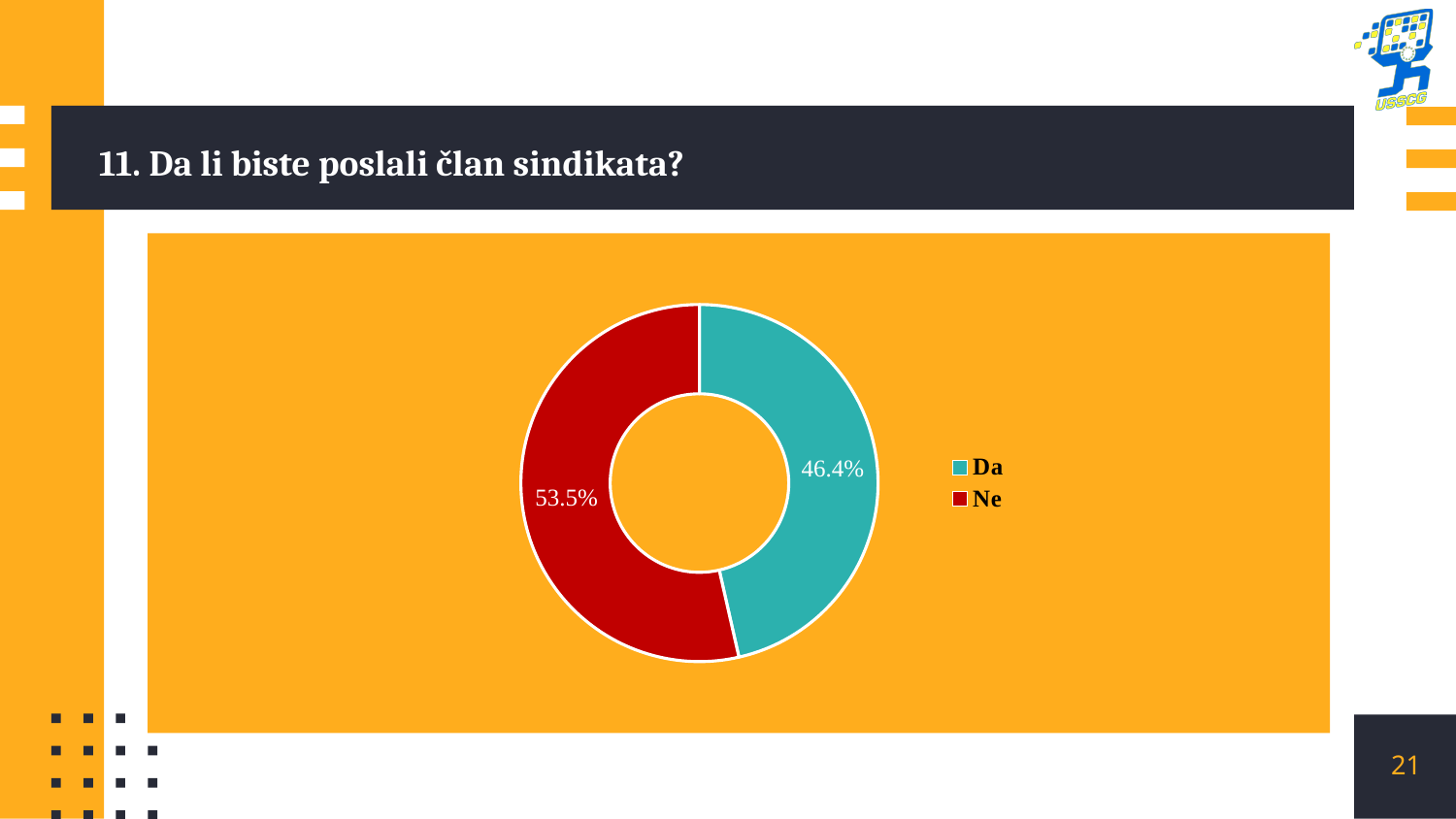
What colour represents "Ne" in the chart? Red Is the share for "Da" greater or less than 50%? less Which category has the largest share of the chart? Ne What percentage of respondents answered "Ne"? 53.5% What percentage of respondents answered "Da"? 46.4% Which category has the smallest share of the chart? Da How many categories are shown in the chart? 2 What is the title of the slide above the chart? 11. Da li biste poslali član sindikata? What is the difference in percentage points between "Ne" and "Da"? 7.1 What kind of chart is shown on the slide? Doughnut chart Which answer has the larger share, "Da" or "Ne"? Ne